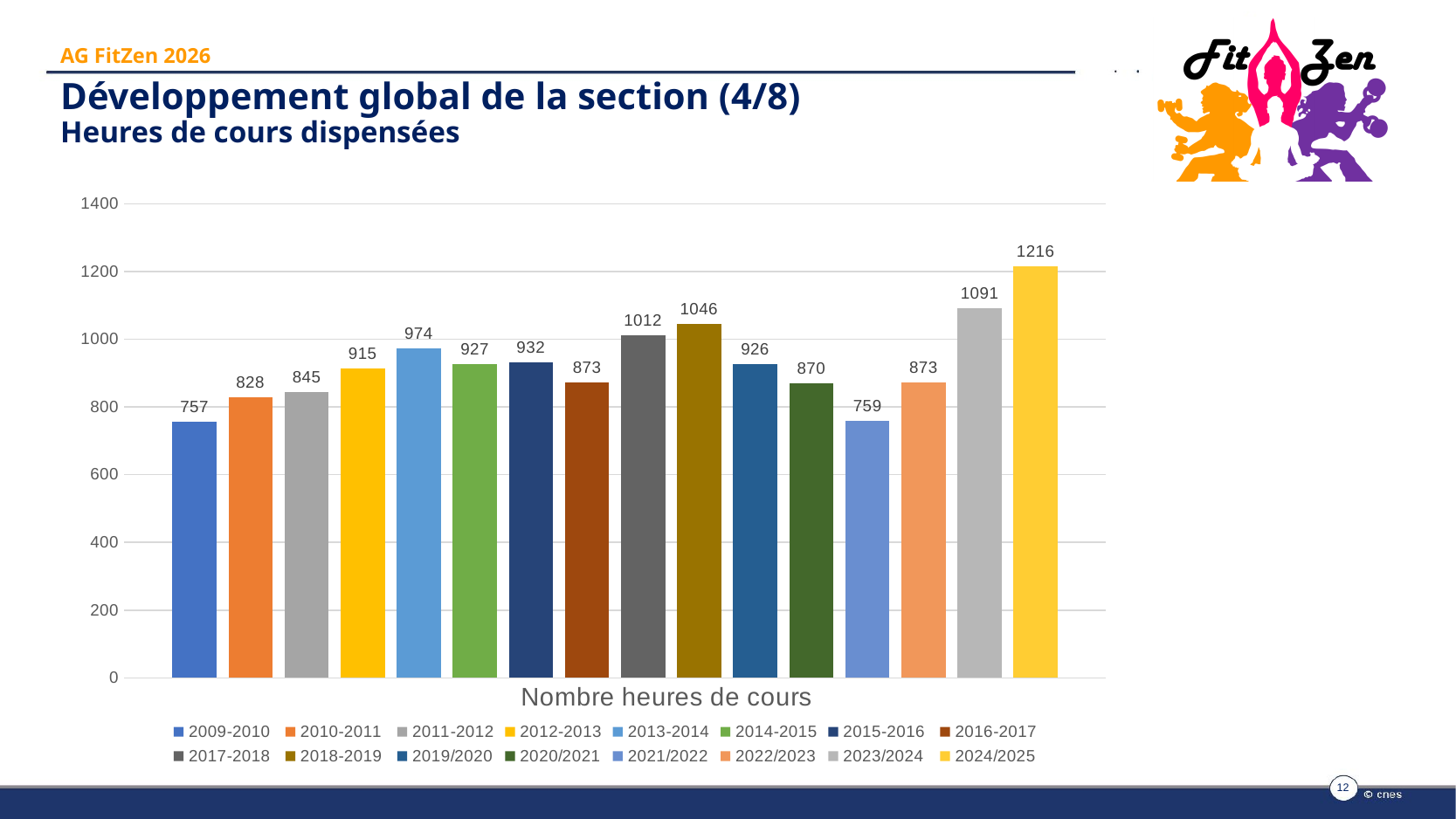
Which season has the lowest number of hours? 2009-2010 What kind of chart is shown on the slide? bar chart How many entries does the legend list? 16 What is the value for 2018-2019? 1046 What is the difference between the values for 2017-2018 and 2016-2017? 139 What is the difference between the values for 2024/2025 and 2023/2024? 125 Which season has the highest number of hours? 2024/2025 Is the value for 2023/2024 greater or less than 1000? greater What is the value for 2021/2022? 759 What is the value for 2009-2010? 757 Which is larger, the value for 2013-2014 or the value for 2015-2016? 2013-2014 How many bars are plotted in the chart? 16